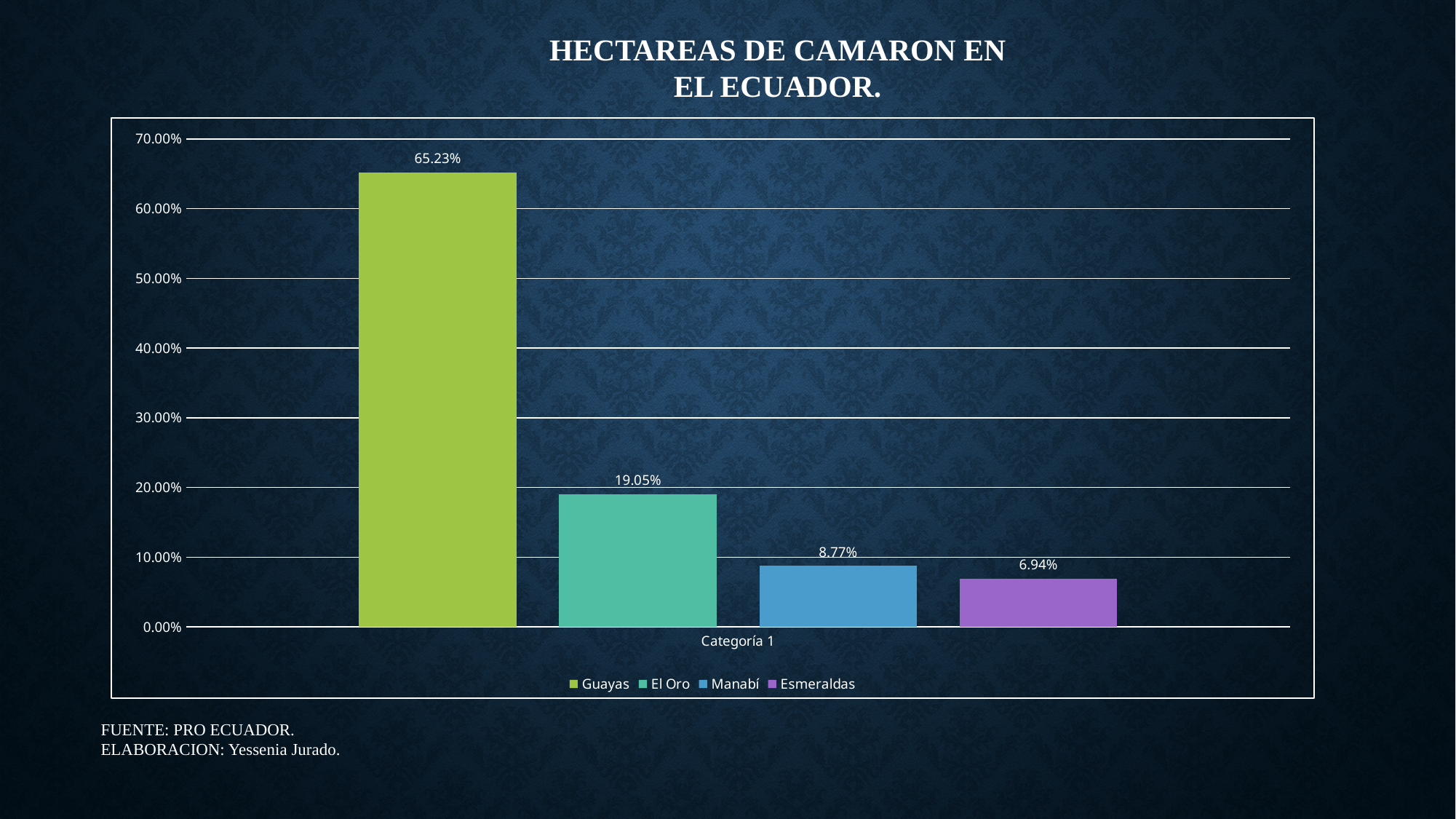
What is the value for Guayas? 65.23% How many series does the legend list? 4 What is the value for Manabí? 8.77% What kind of chart is shown on the slide? bar chart What is the difference between the values for Guayas and El Oro? 46.18% Which series has the lowest value? Esmeraldas What is the title of the chart? HECTAREAS DE CAMARON EN EL ECUADOR. Is the value for El Oro greater or less than 20.00%? less What is the value for El Oro? 19.05% What is the value for Esmeraldas? 6.94% Which is larger, the value for Manabí or the value for Esmeraldas? Manabí Which series has the highest value? Guayas